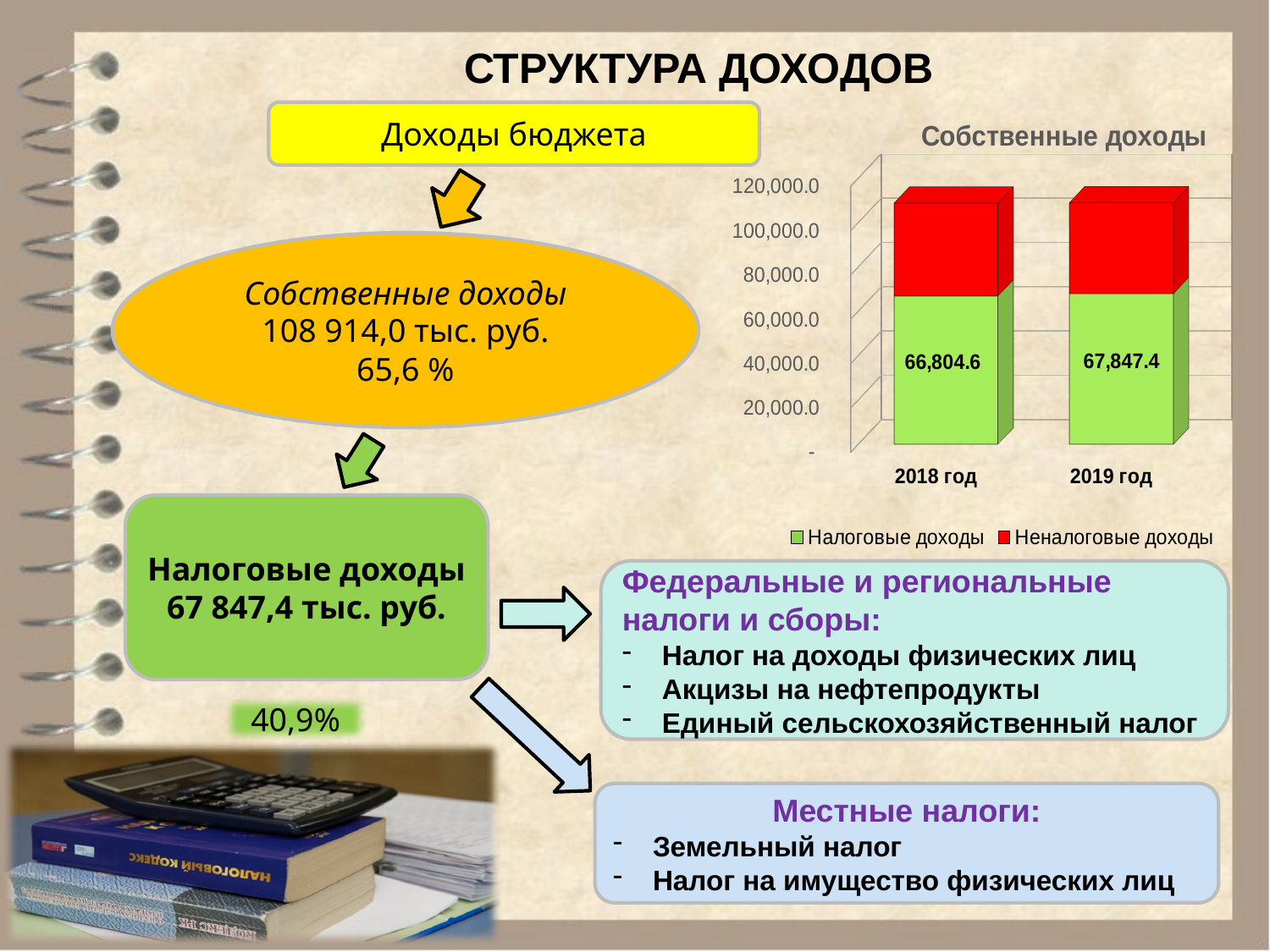
What is the title of the chart on the slide? Собственные доходы In the chart 'Собственные доходы', what is the value of Налоговые доходы for 2019 год? 67,847.4 In the chart 'Собственные доходы', do the values of Налоговые доходы rise or fall from 2018 год to 2019 год? Rise What type of chart is 'Собственные доходы'? Stacked bar chart In the chart 'Собственные доходы', is the total height of the 2018 год bar greater or less than 100,000.0? greater How many series does the legend of the chart 'Собственные доходы' list? 2 In the chart 'Собственные доходы', is the value of Налоговые доходы for 2019 год greater or less than 60,000.0? greater In the chart 'Собственные доходы', by how much did Налоговые доходы change from 2018 год to 2019 год? 1,042.8 In the chart 'Собственные доходы', which colour represents Неналоговые доходы? Red In the chart 'Собственные доходы', which year has the larger value of Налоговые доходы, 2018 год or 2019 год? 2019 год In the chart 'Собственные доходы', what is the value of Налоговые доходы for 2018 год? 66,804.6 How many categories (years) are shown on the x axis of the chart 'Собственные доходы'? 2